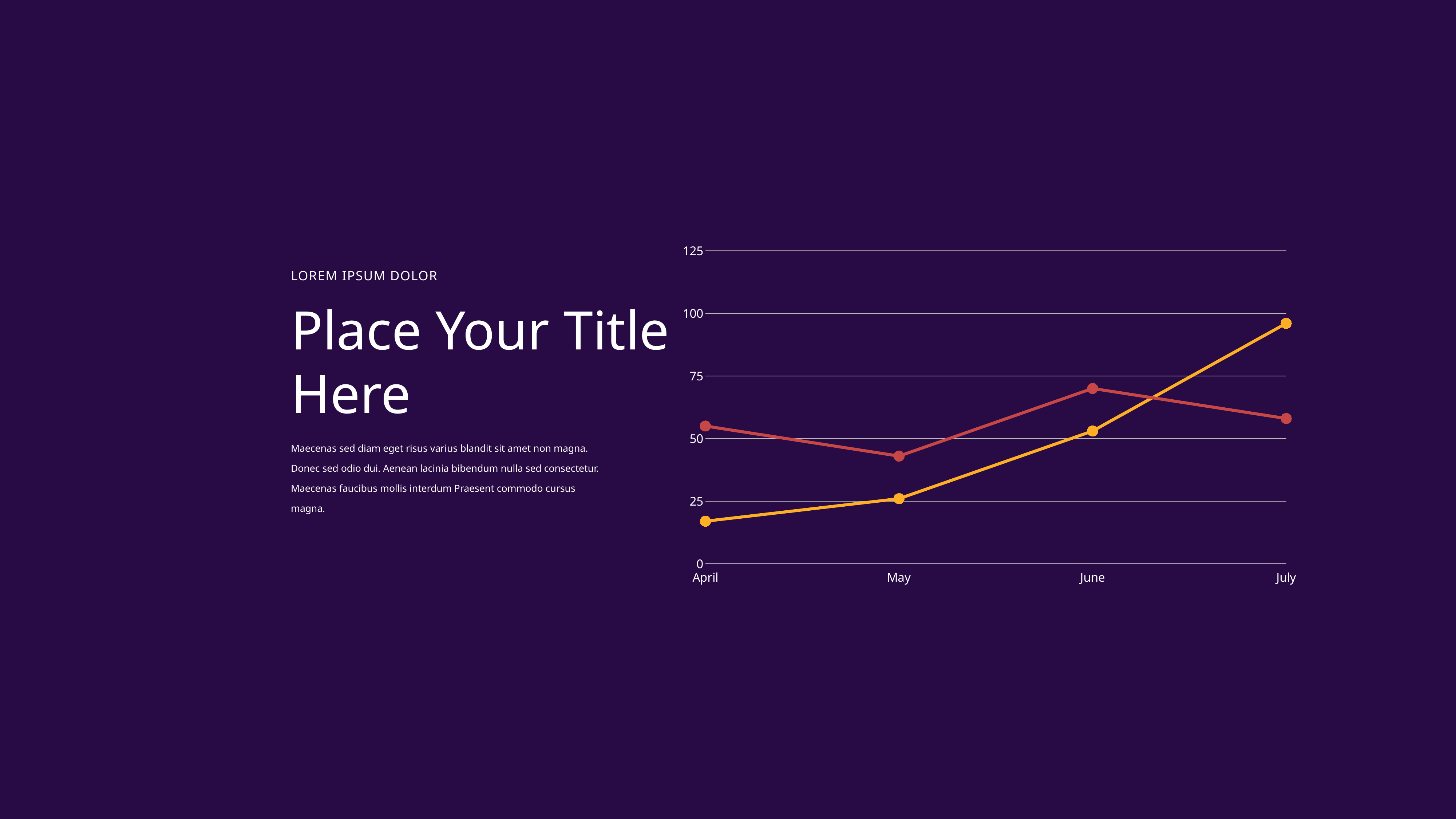
What kind of chart is shown on the slide? line chart In which month does the red line reach its highest value? June Is the value of the red line for May greater or less than 50? less In which month does the yellow line reach its highest value? July How many lines are plotted on the chart? 2 Is the value of the yellow line for July greater or less than 100? less How many months are shown on the x axis of the chart? 4 Is the value of the red line for July greater or less than 50? greater Does the yellow line rise or fall from April to July? rise In which month does the red line reach its lowest value? May In April, which line has the higher value, the yellow line or the red line? the red line